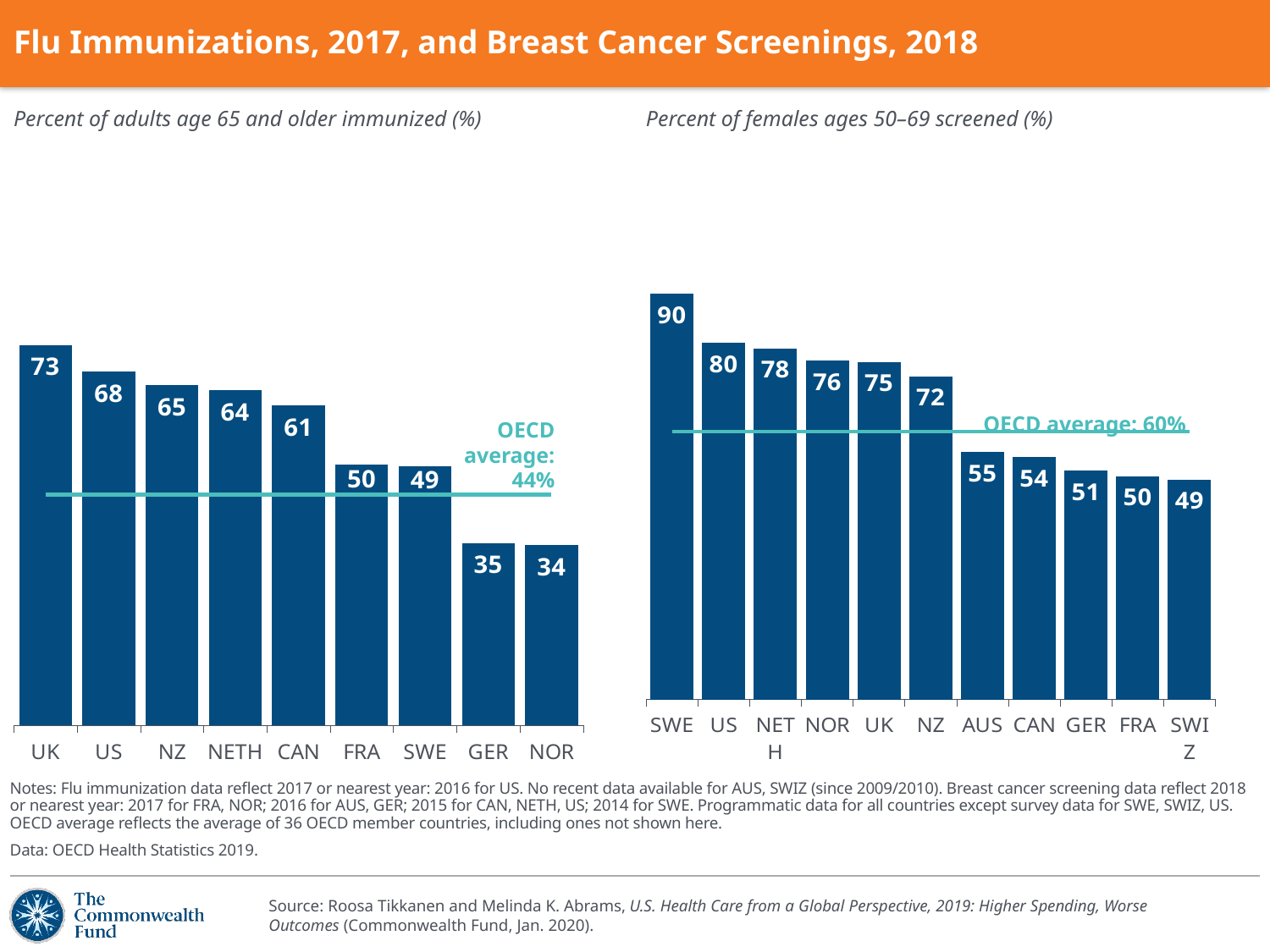
In the breast cancer screenings chart (right), what percent of females ages 50–69 were screened in SWE? 90 In the flu immunizations chart (left), which country has the lowest immunization rate? NOR In the flu immunizations chart (left), what is the difference between the US and GER values? 33 How many countries are shown in the flu immunizations chart (left)? 9 In the flu immunizations chart (left), which is higher, CAN or FRA? CAN In the flu immunizations chart (left), what percent of adults age 65 and older were immunized in the UK? 73 In the flu immunizations chart (left), what OECD average is indicated by the horizontal line? 44% In the breast cancer screenings chart (right), what is the difference between the US and CAN values? 26 How many countries are shown in the breast cancer screenings chart (right)? 11 In the breast cancer screenings chart (right), what OECD average is indicated by the horizontal line? 60% What type of chart is used for the breast cancer screenings data (right)? Bar chart In the breast cancer screenings chart (right), which country has the highest screening rate? SWE